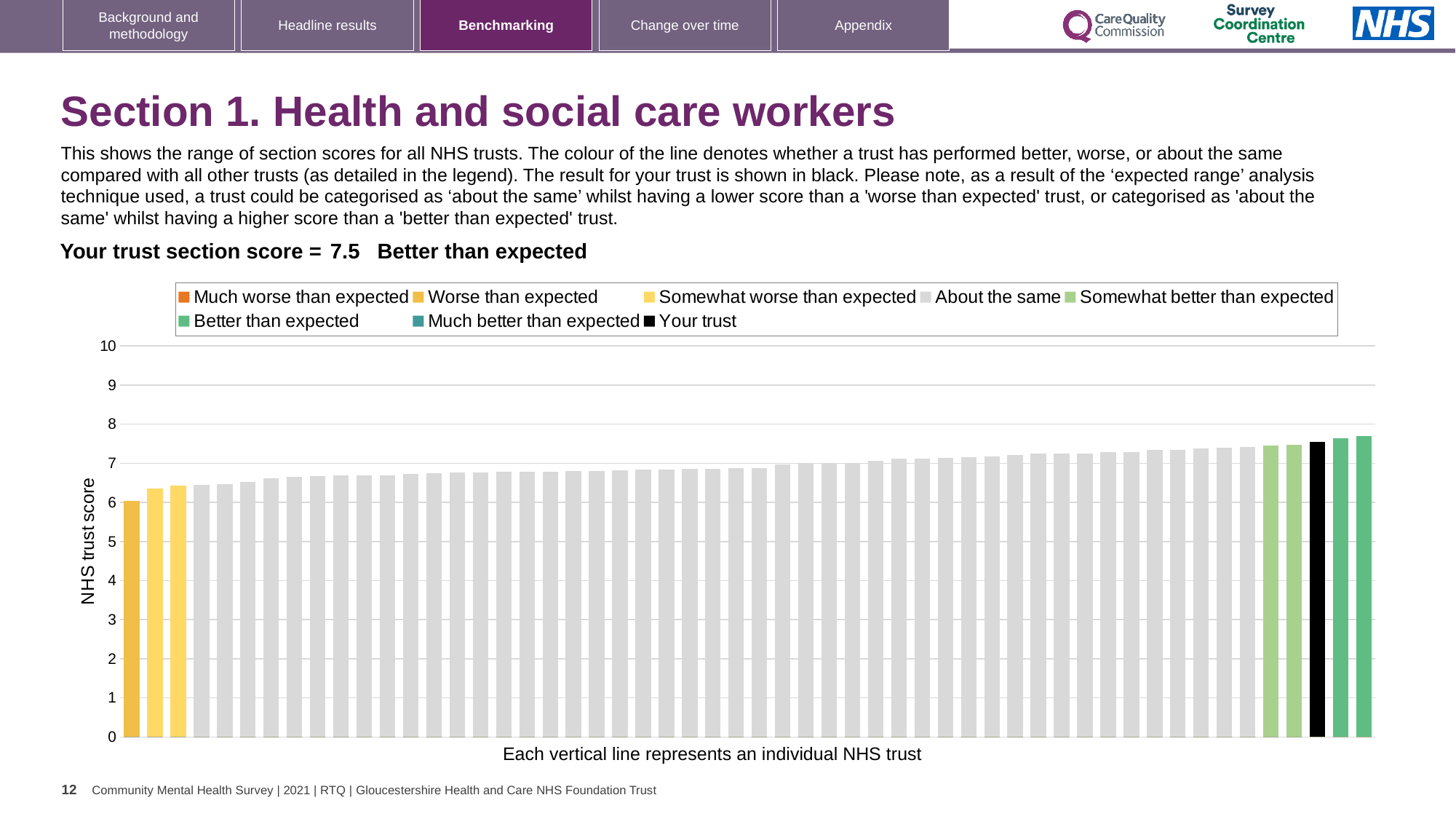
Which is larger, the value of the rightmost bar or the value of the leftmost bar? the rightmost bar Which category does the black bar represent according to the legend? Your trust What is the section score for your trust shown on the slide? 7.5 How many entries does the chart legend list? 8 Is the value of the leftmost bar greater or less than 5? greater Is the value of the rightmost bar greater or less than 8? less Is the value of the black bar (your trust) greater or less than 7? greater What is the label on the vertical axis of the chart? NHS trust score Do the bar values rise or fall from left to right along the x axis? rise What kind of chart is shown on the slide? bar chart